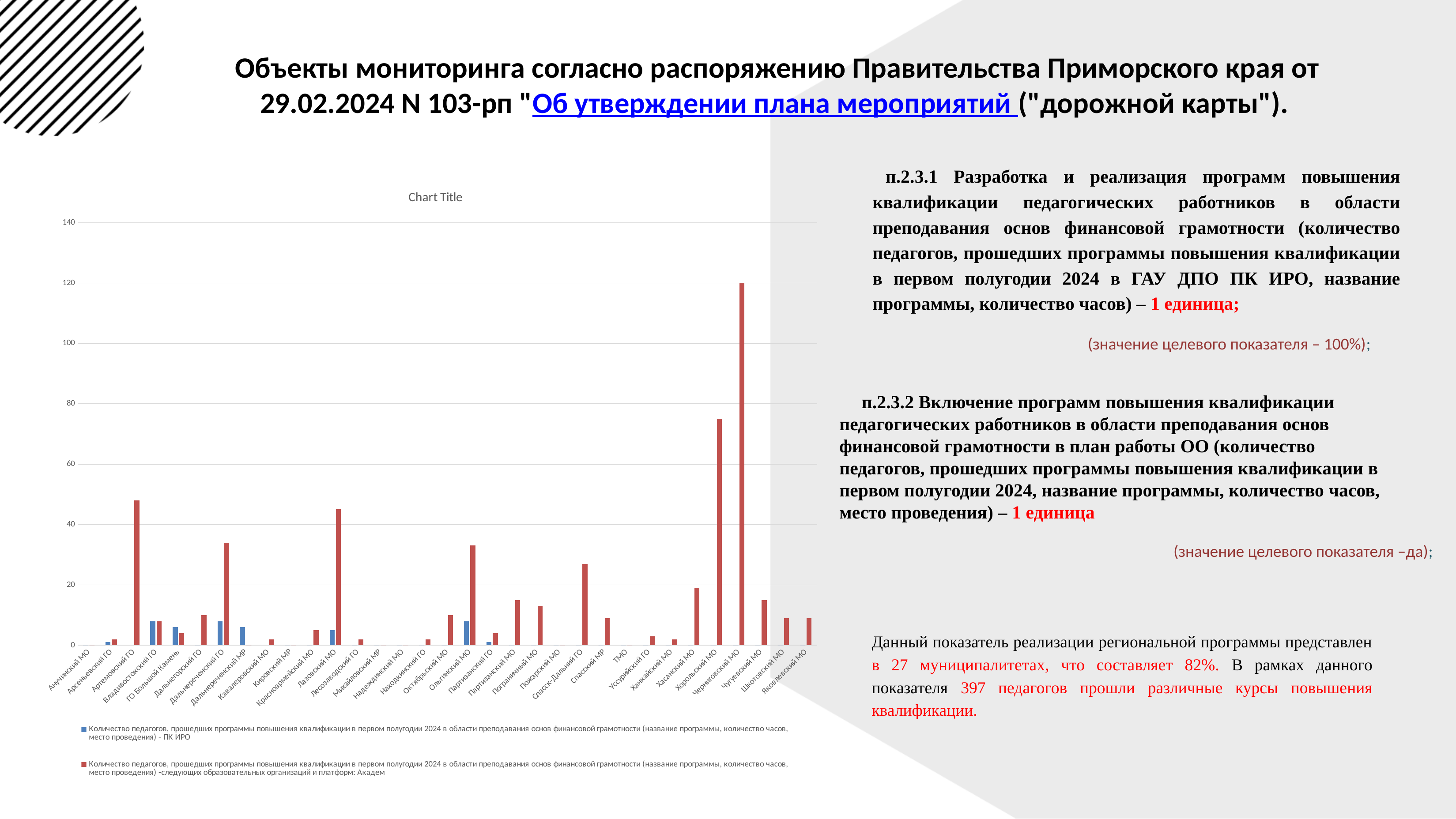
What is the title shown above the chart? Chart Title What kind of chart is shown on the slide? bar chart Which has the larger red (Академ) bar: Чугуевский МО or Черниговский МО? Черниговский МО Is the red (Академ) value for Чугуевский МО greater or less than 100? less Is the red (Академ) value for Артемовский ГО greater or less than 40? greater Is the red (Академ) value for Хорольский МО greater or less than 20? greater Which has the larger red (Академ) bar: Артемовский ГО or Хорольский МО? Хорольский МО Which category has the highest red (Академ) bar in the chart? Черниговский МО Which colour represents the ПК ИРО series in the chart? blue How many series does the chart legend list? 2